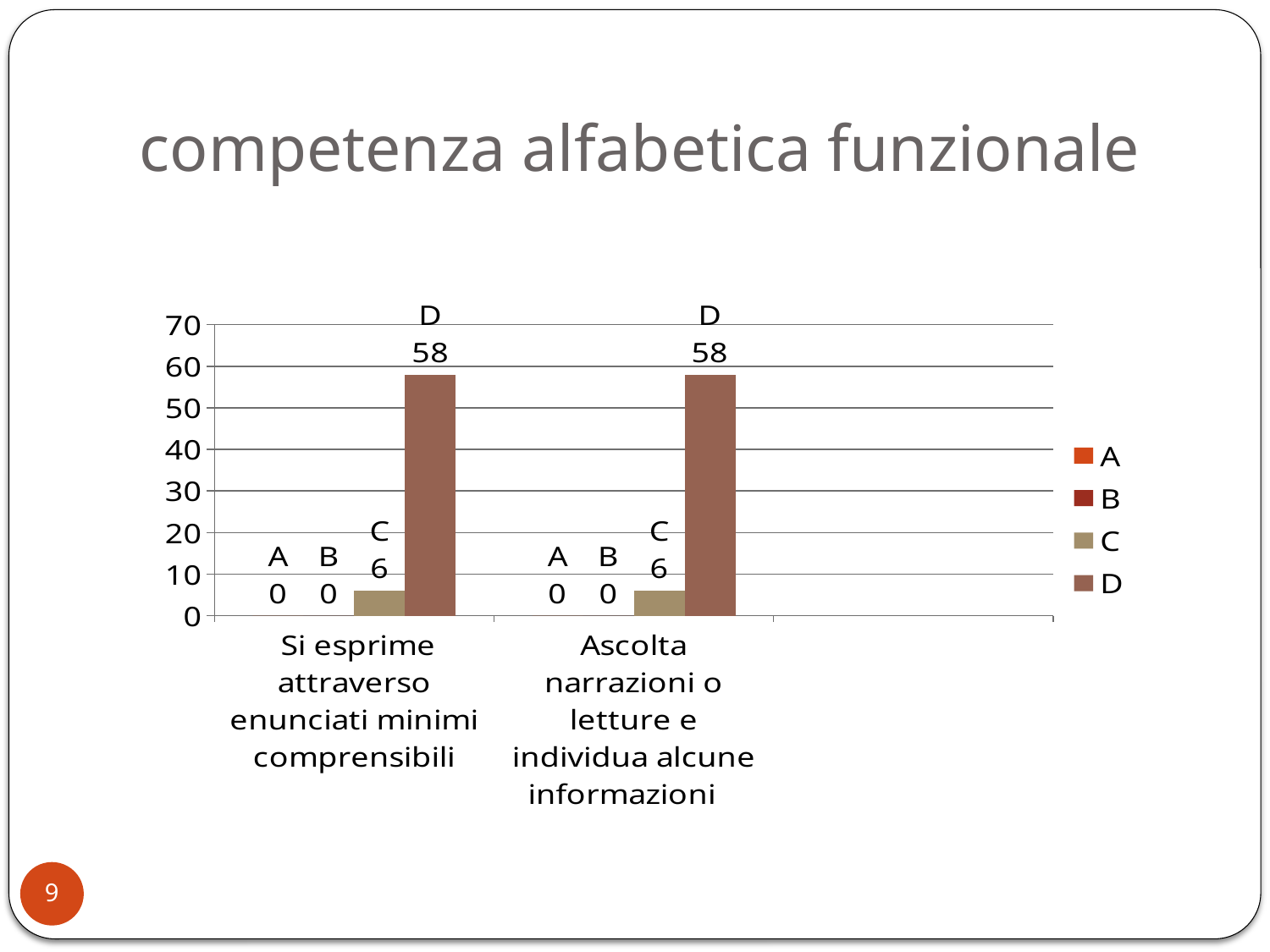
What is the value for series C in the category "Ascolta narrazioni o letture e individua alcune informazioni"? 6 What is the value for series D in the category "Si esprime attraverso enunciati minimi comprensibili"? 58 How many series does the legend list? 4 Is the value for series D in the category "Si esprime attraverso enunciati minimi comprensibili" greater or less than 50? greater What is the value for series A in the category "Si esprime attraverso enunciati minimi comprensibili"? 0 What kind of chart is shown on the slide? bar chart How many categories are shown on the x axis of the chart? 2 What is the title of the slide containing the chart? competenza alfabetica funzionale Which is larger in the category "Ascolta narrazioni o letture e individua alcune informazioni": the value for series C or the value for series D? D What is the difference between the values for series D and series C in the category "Si esprime attraverso enunciati minimi comprensibili"? 52 Which series has the highest value in the category "Ascolta narrazioni o letture e individua alcune informazioni"? D What is the value for series B in the category "Ascolta narrazioni o letture e individua alcune informazioni"? 0